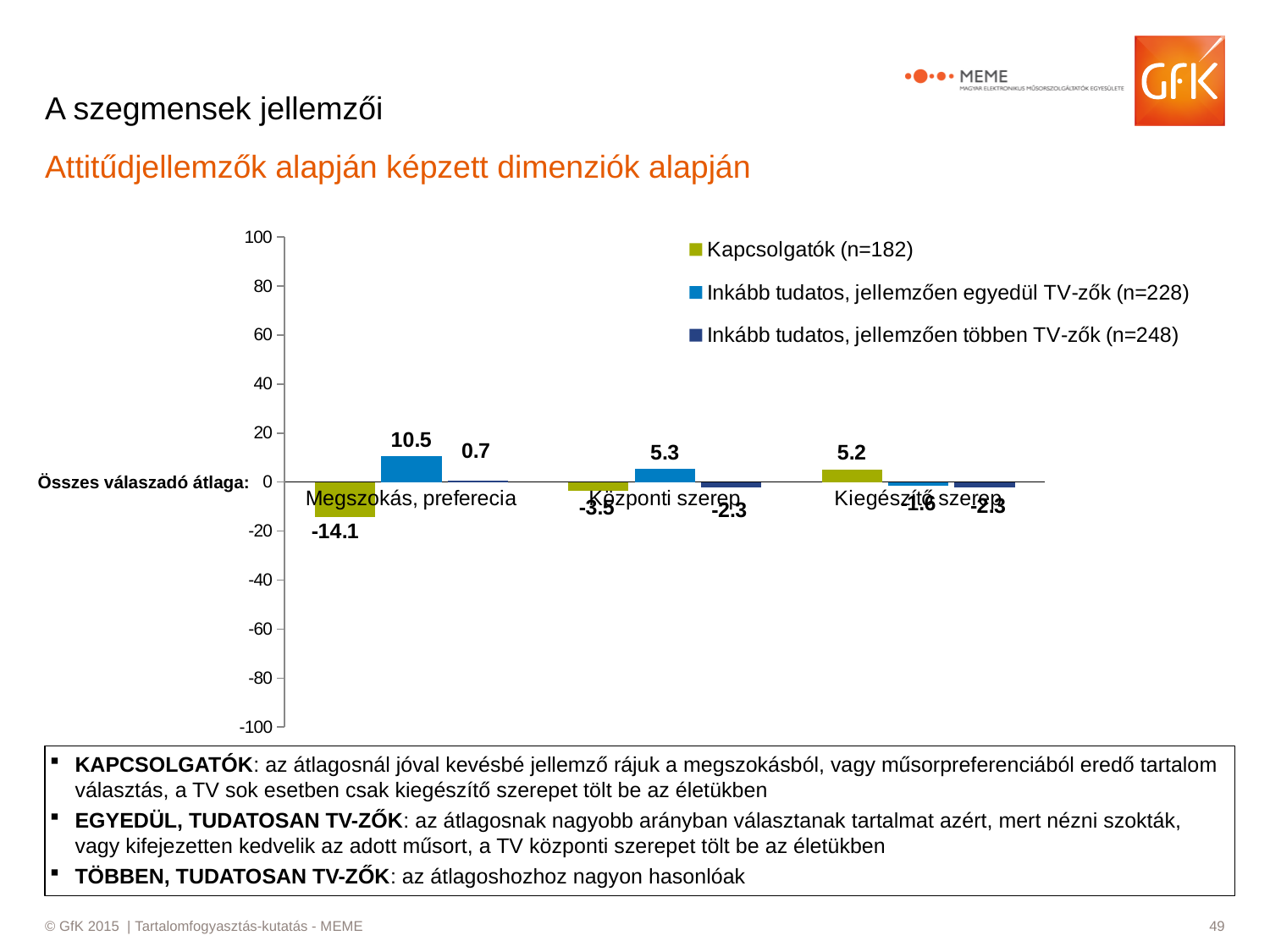
What kind of chart is shown on the slide? Bar chart Which category has the highest value for Inkább tudatos, jellemzően egyedül TV-zők (n=228)? Megszokás, preferecia How many series does the chart legend list? 3 What is the value for Inkább tudatos, jellemzően egyedül TV-zők (n=228) in the Megszokás, preferecia category? 10.5 How many categories are shown on the x axis of the chart? 3 Which category has the lowest value for Kapcsolgatók (n=182)? Megszokás, preferecia What is the value for Kapcsolgatók (n=182) in the Kiegészítő szerep category? 5.2 What is the value for Inkább tudatos, jellemzően egyedül TV-zők (n=228) in the Központi szerep category? 5.3 What is the difference between the Inkább tudatos, jellemzően egyedül TV-zők (n=228) value and the Kapcsolgatók (n=182) value in the Megszokás, preferecia category? 24.6 What is the value for Inkább tudatos, jellemzően többen TV-zők (n=248) in the Megszokás, preferecia category? 0.7 In the Központi szerep category, which is larger: the value for Kapcsolgatók (n=182) or for Inkább tudatos, jellemzően egyedül TV-zők (n=228)? Inkább tudatos, jellemzően egyedül TV-zők (n=228) What is the value for Kapcsolgatók (n=182) in the Megszokás, preferecia category? -14.1